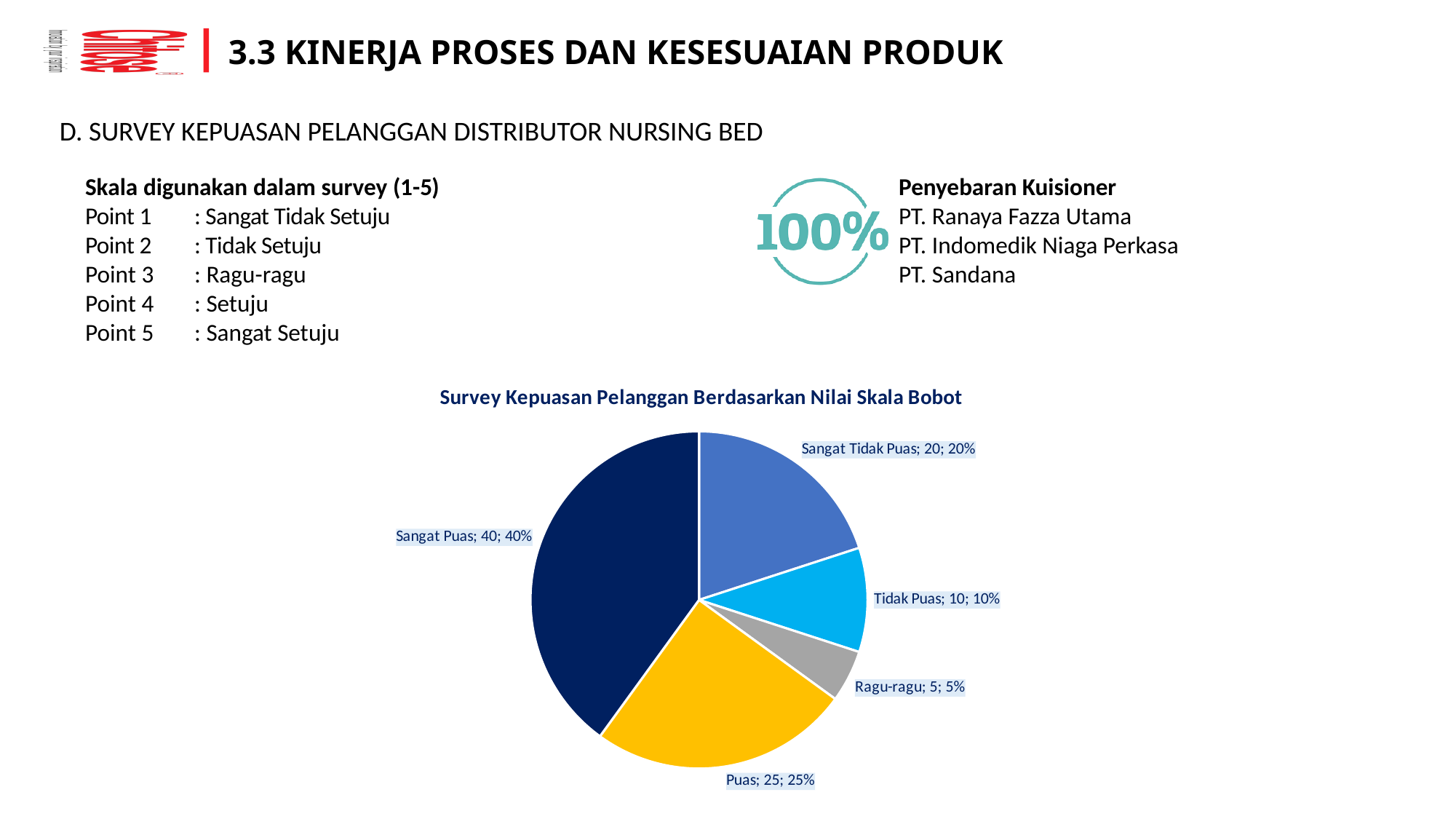
Which is larger, Puas or Sangat Tidak Puas? Puas Which category has the largest slice? Sangat Puas What percentage share does Ragu-ragu have? 5% What is the title of the chart? Survey Kepuasan Pelanggan Berdasarkan Nilai Skala Bobot What is the difference between the values for Sangat Puas and Sangat Tidak Puas? 20 What is the value for Tidak Puas? 10 What type of chart is shown on the slide? pie chart Which category has the smallest slice? Ragu-ragu What is the value for Sangat Puas? 40 What colour is the Puas slice? yellow How many slices does the pie chart have? 5 What percentage share does Puas have? 25%